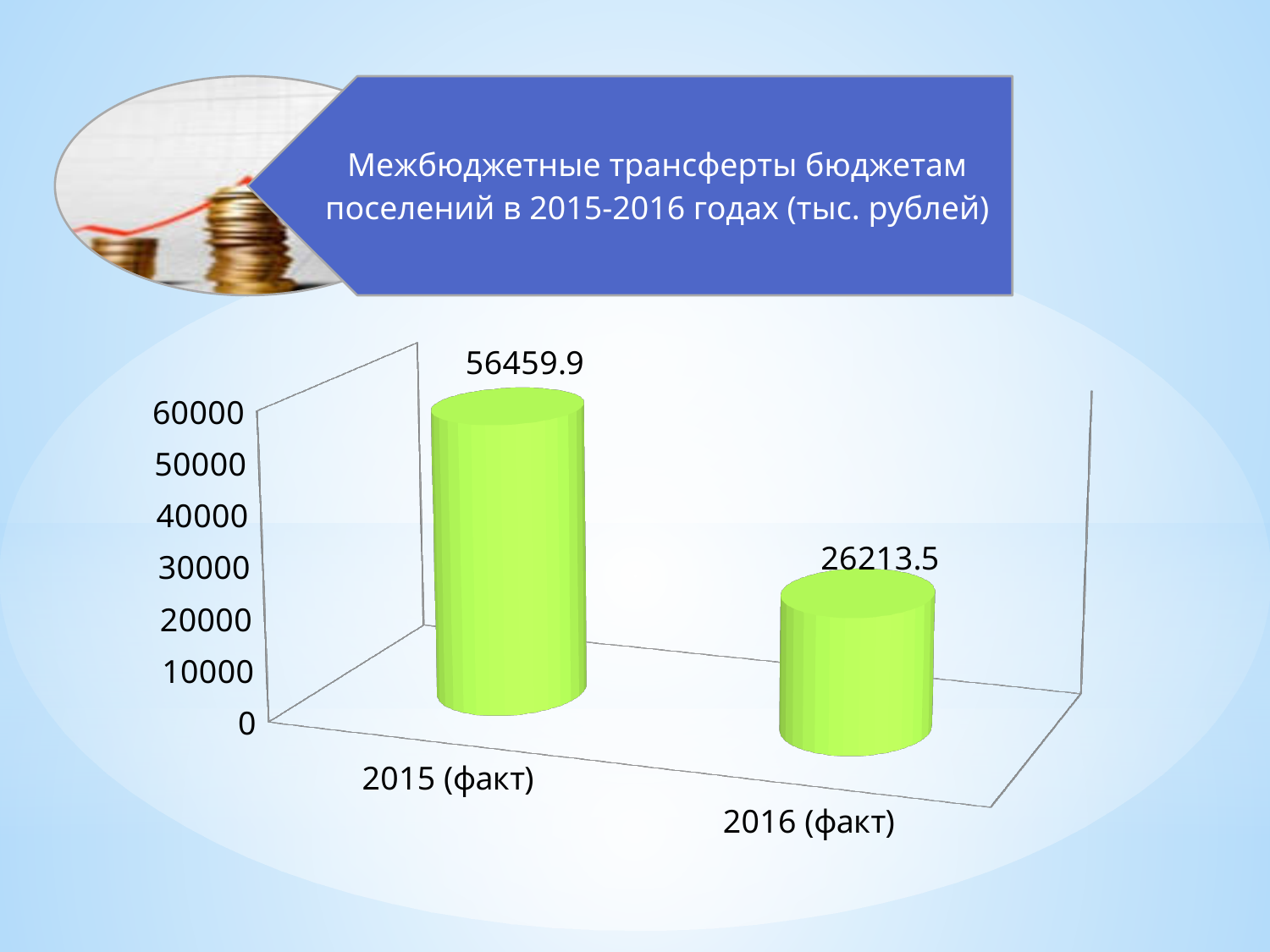
What is the difference between the values for 2015 (факт) and 2016 (факт)? 30246.4 Is the value for 2016 (факт) greater or less than 30000? less Which is larger, the value for 2015 (факт) or 2016 (факт)? 2015 (факт) Which category has the highest value? 2015 (факт) What is the value for 2015 (факт)? 56459.9 What is the value for 2016 (факт)? 26213.5 How many categories are shown in the chart? 2 What is the title shown above the chart? Межбюджетные трансферты бюджетам поселений в 2015-2016 годах (тыс. рублей) Do the values rise or fall from 2015 (факт) to 2016 (факт)? fall Is the value for 2015 (факт) greater or less than 50000? greater What kind of chart is shown on the slide? bar chart Which category has the lowest value? 2016 (факт)